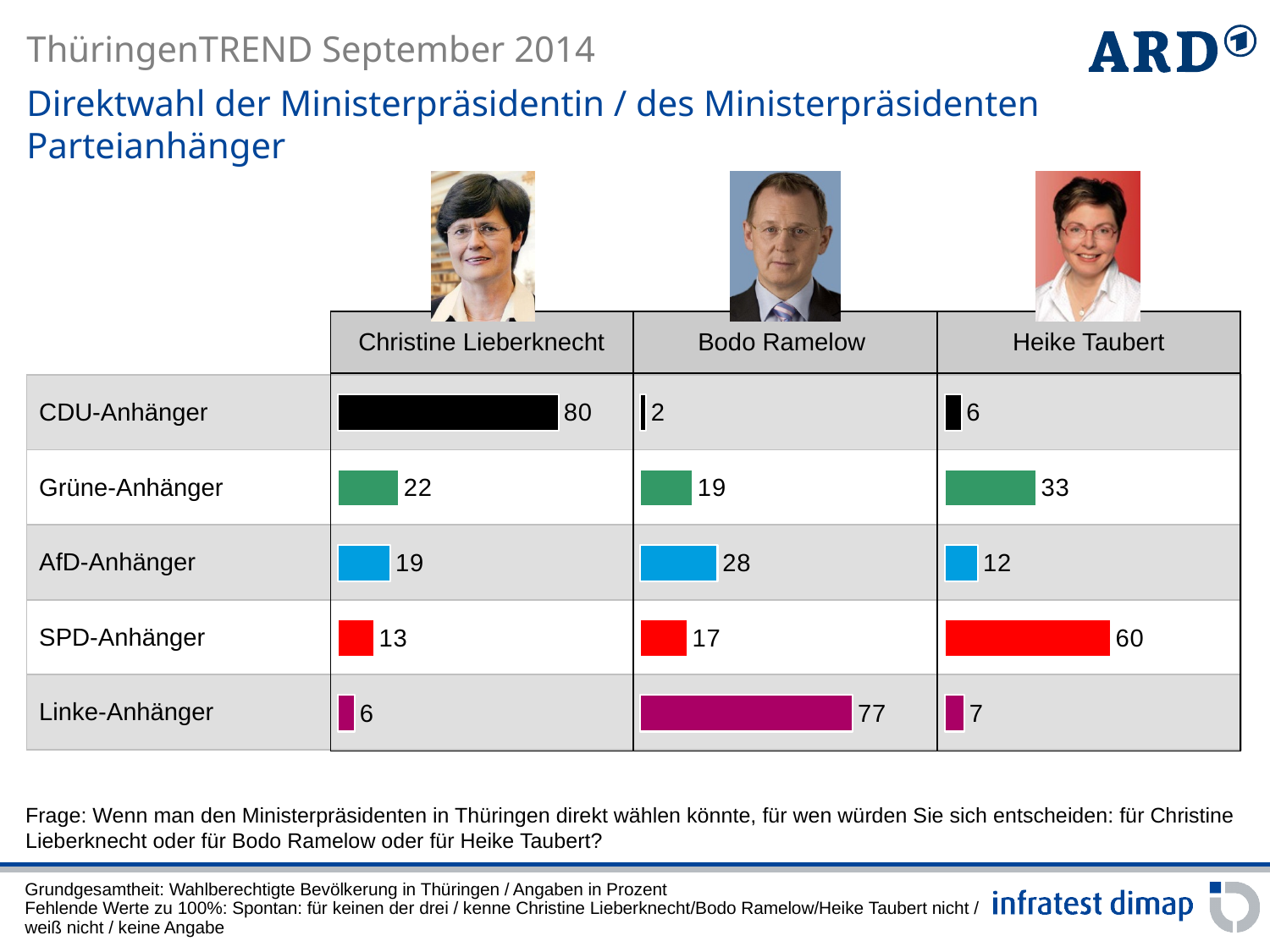
What is the difference between Heike Taubert's and Christine Lieberknecht's values among SPD-Anhänger? 47 What value is shown for Bodo Ramelow among AfD-Anhänger? 28 What value is shown for Heike Taubert among SPD-Anhänger? 60 How many groups of party supporters (Anhänger) are listed in the chart? 5 What value is shown for Bodo Ramelow among Linke-Anhänger? 77 Among CDU-Anhänger, which candidate has the lowest value? Bodo Ramelow Among Grüne-Anhänger, which candidate has the highest value? Heike Taubert What percentage of CDU-Anhänger would choose Christine Lieberknecht? 80 What is the difference between Bodo Ramelow's and Heike Taubert's values among AfD-Anhänger? 16 What colour are the bars in the Linke-Anhänger row? Purple Among Grüne-Anhänger, who has the larger value: Christine Lieberknecht or Bodo Ramelow? Christine Lieberknecht What kind of chart is used to display the values? Bar chart